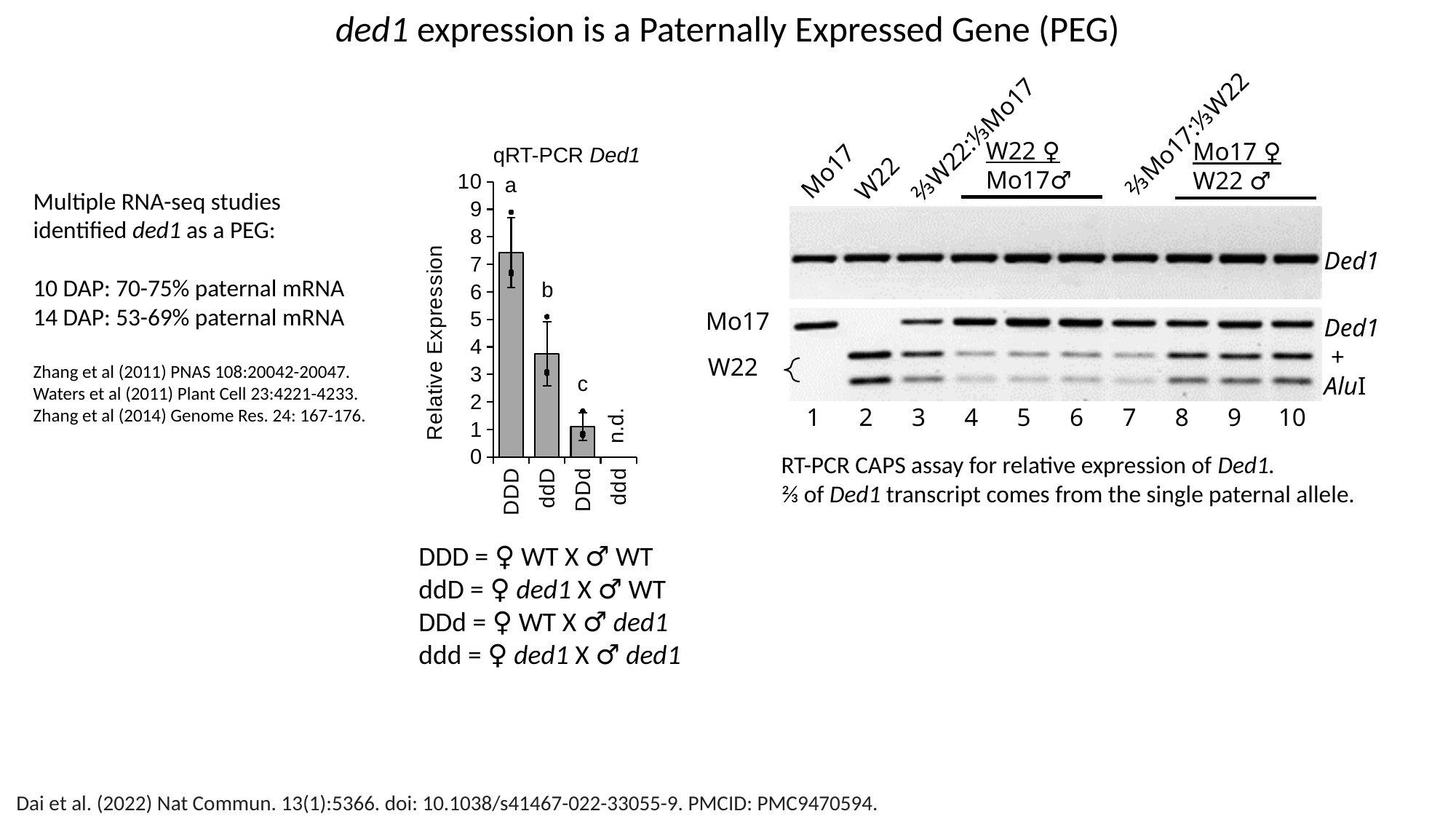
What is the label of the y axis of the qRT-PCR Ded1 chart? Relative Expression Which has the larger relative expression, DDD or ddD? DDD Which category in the qRT-PCR Ded1 chart is marked n.d.? ddd What is the highest tick value shown on the y axis of the qRT-PCR Ded1 chart? 10 Is the relative expression for DDD greater or less than 5? greater How many categories are shown on the x axis of the qRT-PCR Ded1 bar chart? 4 Do the bar values rise or fall from left to right across DDD, ddD, DDd and ddd? fall Which category has the highest relative expression in the qRT-PCR Ded1 chart? DDD What kind of chart is the qRT-PCR Ded1 chart? bar chart Is the relative expression for DDd greater or less than 2? less